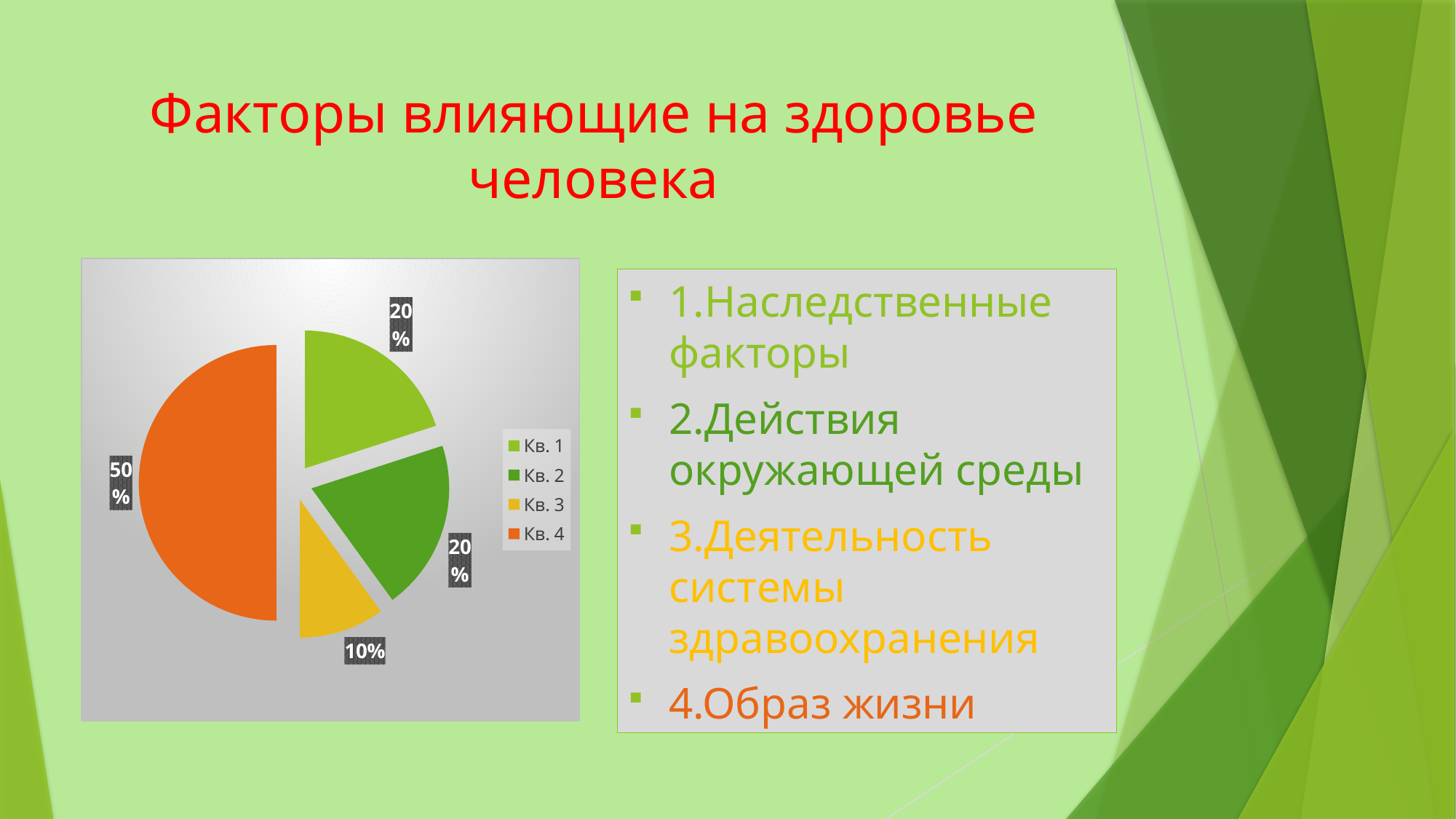
What percentage is shown for Кв. 4 in the pie chart? 50% What percentage is shown for Кв. 2 in the pie chart? 20% How many entries does the legend of the pie chart list? 4 Which category has the largest slice of the pie chart? Кв. 4 Which category has the smallest slice of the pie chart? Кв. 3 Which is larger in the pie chart, Кв. 4 or Кв. 3? Кв. 4 What kind of chart is shown on the slide? pie chart What percentage is shown for Кв. 3 in the pie chart? 10% What colour is the Кв. 4 slice in the pie chart? orange How many slices does the pie chart have? 4 What percentage is shown for Кв. 1 in the pie chart? 20% What is the difference in percentage points between Кв. 4 and Кв. 3? 40